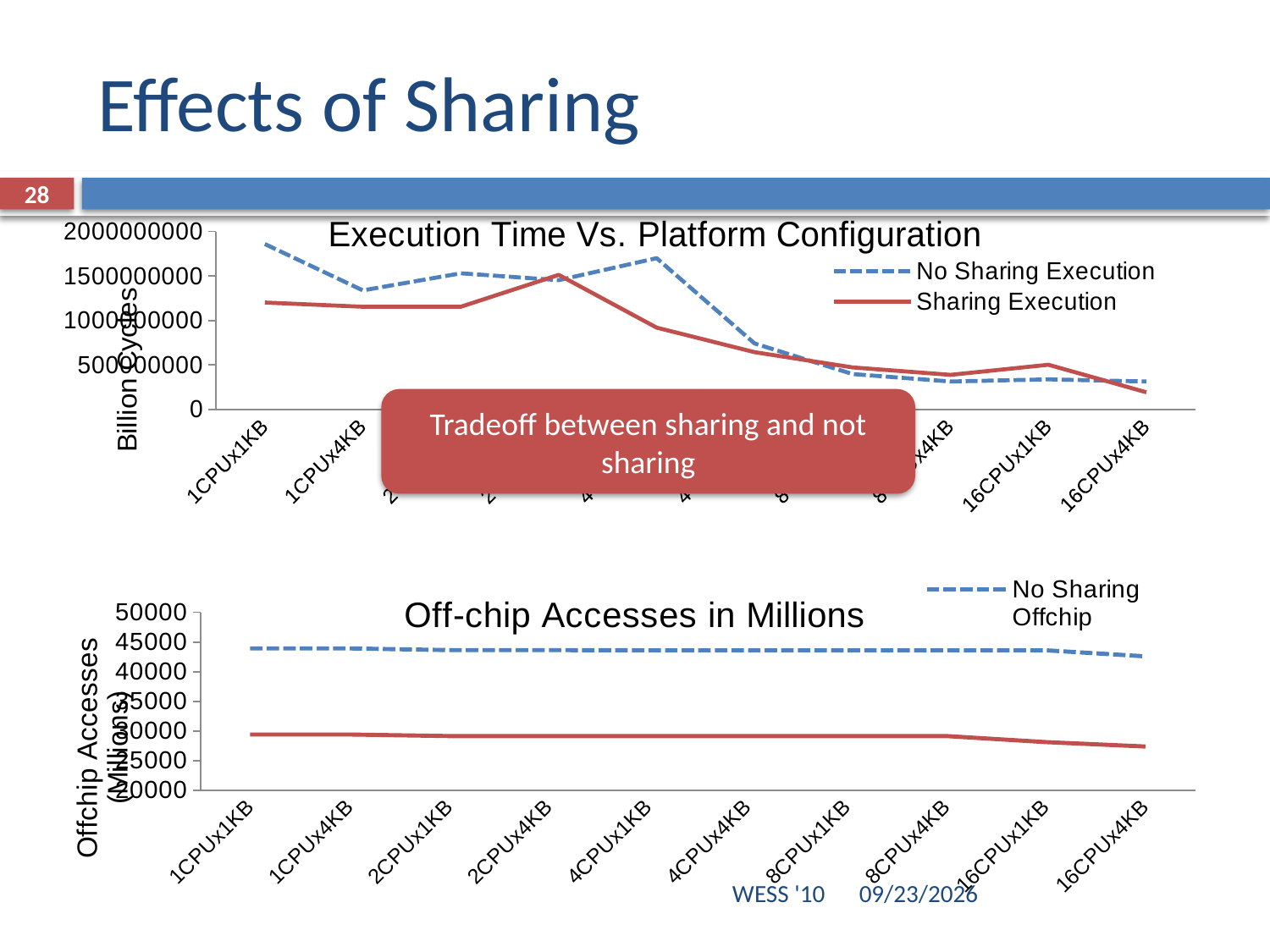
In the "Execution Time Vs. Platform Configuration" chart, does the Sharing Execution series overall rise or fall from 1CPUx1KB to 16CPUx4KB? fall What type of chart is the "Execution Time Vs. Platform Configuration" chart? line chart In the "Execution Time Vs. Platform Configuration" chart, is the value of No Sharing Execution at 1CPUx1KB greater or less than 1500000000? greater How many series does the legend of the "Execution Time Vs. Platform Configuration" chart list? 2 In the "Off-chip Accesses in Millions" chart, is the value of the solid red line at 16CPUx4KB greater or less than 30000? less What is the y-axis label of the "Off-chip Accesses in Millions" chart? Offchip Accesses (Millions) How many platform configurations are shown on the x axis of the "Off-chip Accesses in Millions" chart? 10 In the "Execution Time Vs. Platform Configuration" chart, is the value of Sharing Execution at 16CPUx4KB greater or less than 500000000? less In the "Execution Time Vs. Platform Configuration" chart, which series is drawn with a dashed line? No Sharing Execution In the "Execution Time Vs. Platform Configuration" chart, at 1CPUx1KB, which series has the higher value: No Sharing Execution or Sharing Execution? No Sharing Execution What type of chart is the "Off-chip Accesses in Millions" chart? line chart